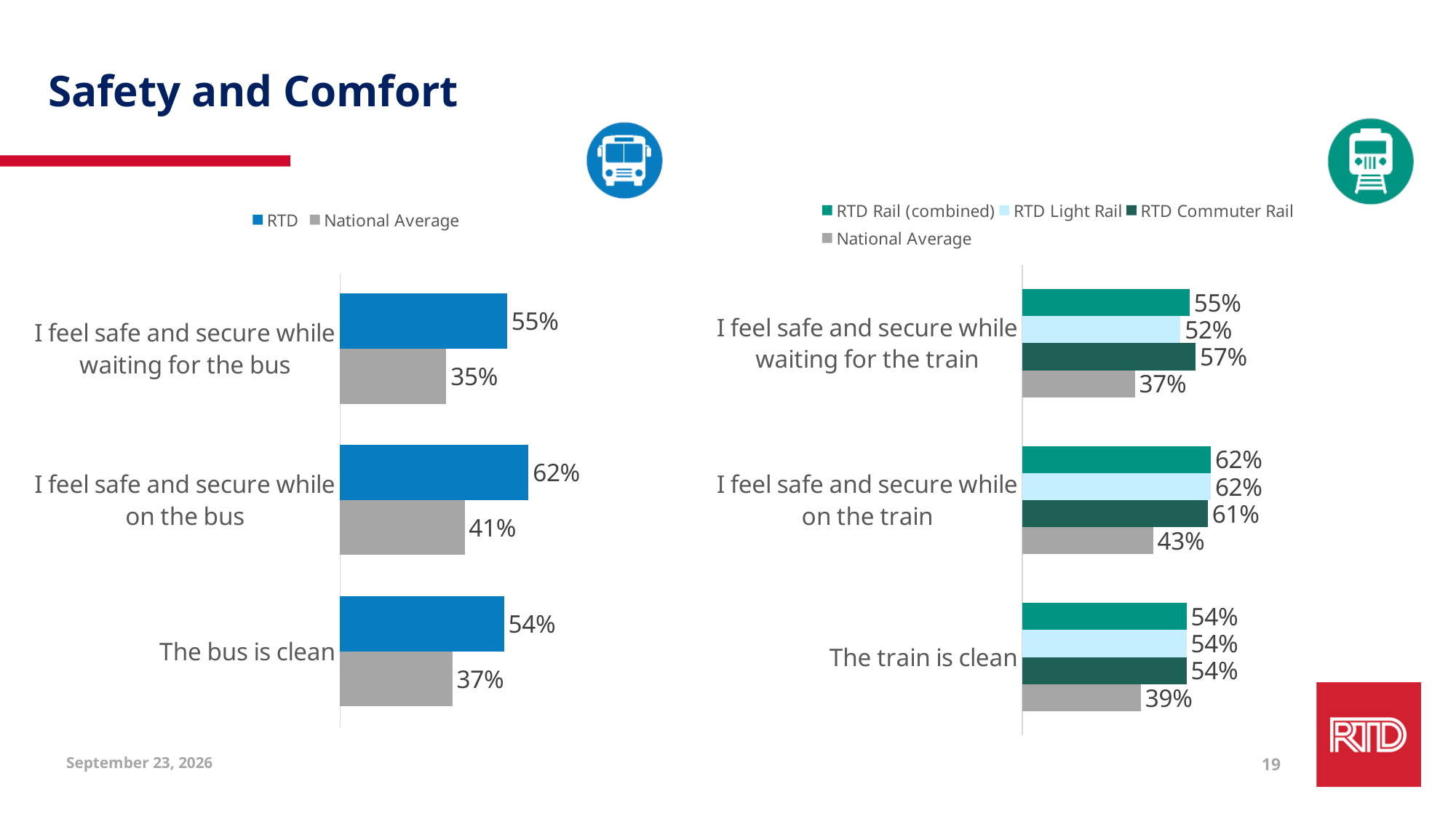
What kind of chart is the bus chart on the left? Bar chart In the bus chart on the left, what is the RTD value for 'I feel safe and secure while on the bus'? 62% In the bus chart on the left, which category has the lowest National Average value? I feel safe and secure while waiting for the bus In the train chart on the right, which is larger for 'I feel safe and secure while waiting for the train': RTD Light Rail or RTD Commuter Rail? RTD Commuter Rail How many categories are shown in the bus chart on the left? 3 In the bus chart on the left, what is the difference between the RTD and National Average values for 'I feel safe and secure while waiting for the bus'? 20% In the train chart on the right, what is the RTD Commuter Rail value for 'I feel safe and secure while waiting for the train'? 57% In the bus chart on the left, what is the National Average value for 'The bus is clean'? 37% How many series does the legend of the train chart on the right list? 4 In the bus chart on the left, which category has the highest RTD value? I feel safe and secure while on the bus In the train chart on the right, what is the National Average value for 'I feel safe and secure while on the train'? 43% In the train chart on the right, what is the difference between the RTD Commuter Rail and RTD Light Rail values for 'I feel safe and secure while waiting for the train'? 5%